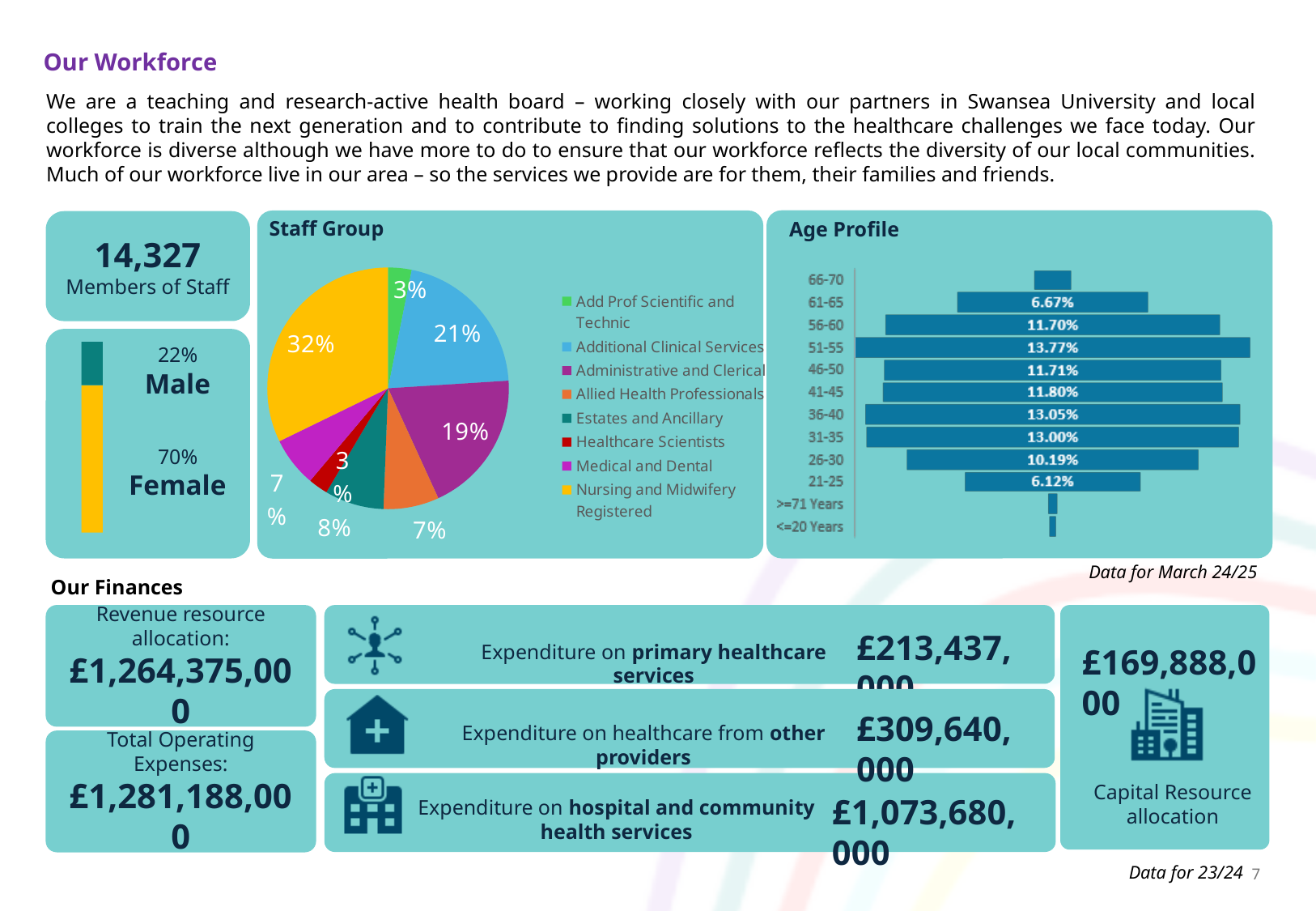
How many age bands are shown in the Age Profile chart? 12 In the Staff Group pie chart, how many percentage points larger is Nursing and Midwifery Registered than Administrative and Clerical? 13 percentage points In the Age Profile chart, which age band has the highest value? 51-55 In the Staff Group pie chart, which staff group has the largest share? Nursing and Midwifery Registered What kind of chart is the Age Profile chart? bar chart In the Age Profile chart, what is the value for the 51-55 age band? 13.77% How many staff groups does the legend of the Staff Group pie chart list? 8 In the Staff Group pie chart, which is larger: Estates and Ancillary or Allied Health Professionals? Estates and Ancillary In the Age Profile chart, which is larger: the value for 61-65 or the value for 21-25? 61-65 What kind of chart is the Staff Group chart? pie chart In the Staff Group pie chart, what share of staff is Additional Clinical Services? 21% In the Staff Group pie chart, what share of staff is Nursing and Midwifery Registered? 32%